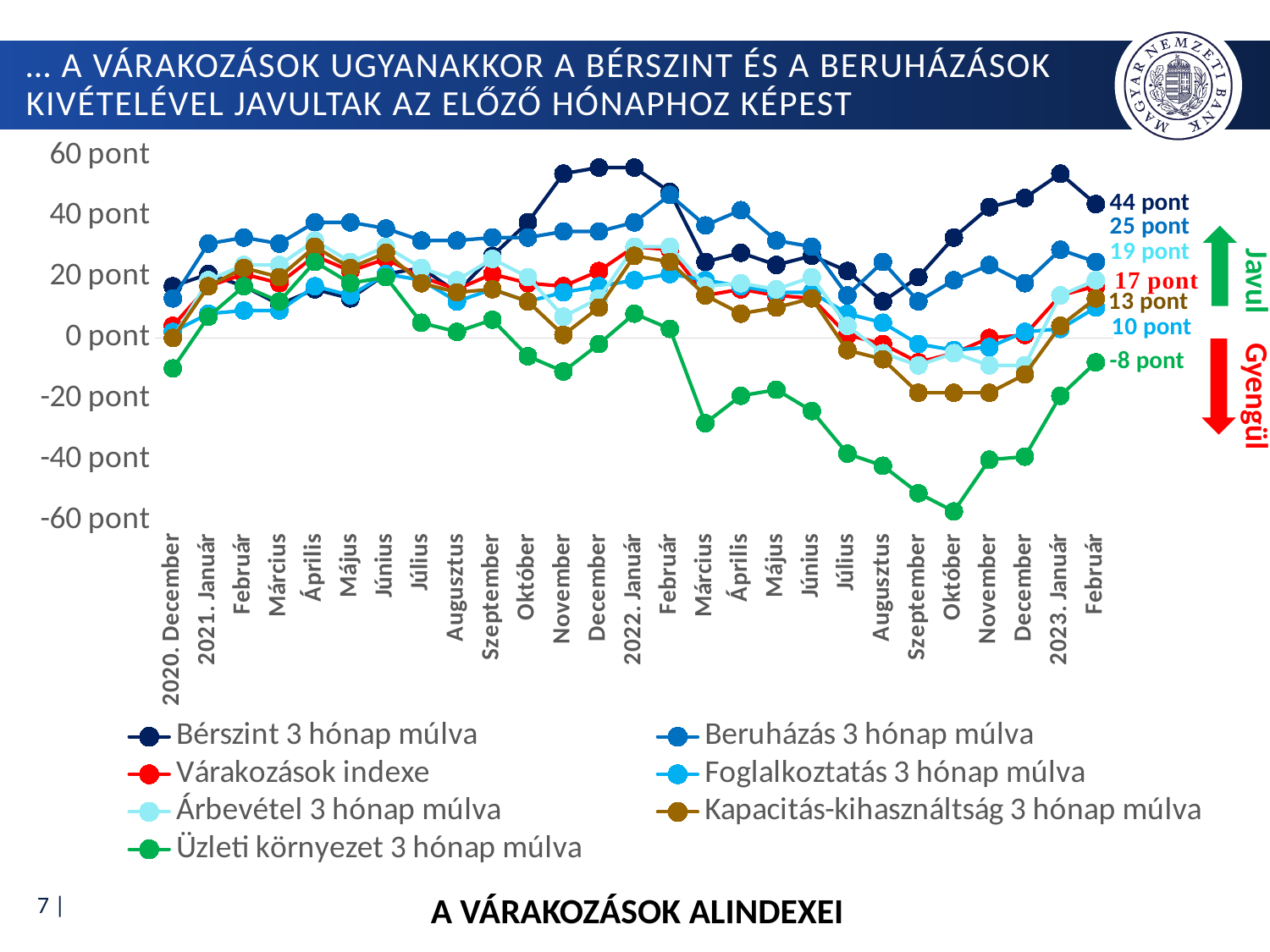
What is the value of Várakozások indexe in 2023 Február? 17 pont What is the value of Üzleti környezet 3 hónap múlva in 2023 Február? -8 pont What is the difference between Bérszint 3 hónap múlva and Üzleti környezet 3 hónap múlva in 2023 Február? 52 pont Is the value for Üzleti környezet 3 hónap múlva in 2022 Október greater or less than -40 pont? less What kind of chart is shown on the slide? line chart Which series has the highest value in 2023 Február? Bérszint 3 hónap múlva What is the value of Bérszint 3 hónap múlva in 2023 Február? 44 pont In 2023 Február, which is larger: Beruházás 3 hónap múlva or Foglalkoztatás 3 hónap múlva? Beruházás 3 hónap múlva How many months are shown on the x axis? 27 What is the value of Beruházás 3 hónap múlva in 2023 Február? 25 pont How many series does the legend list? 7 Which series has the lowest value in 2023 Február? Üzleti környezet 3 hónap múlva